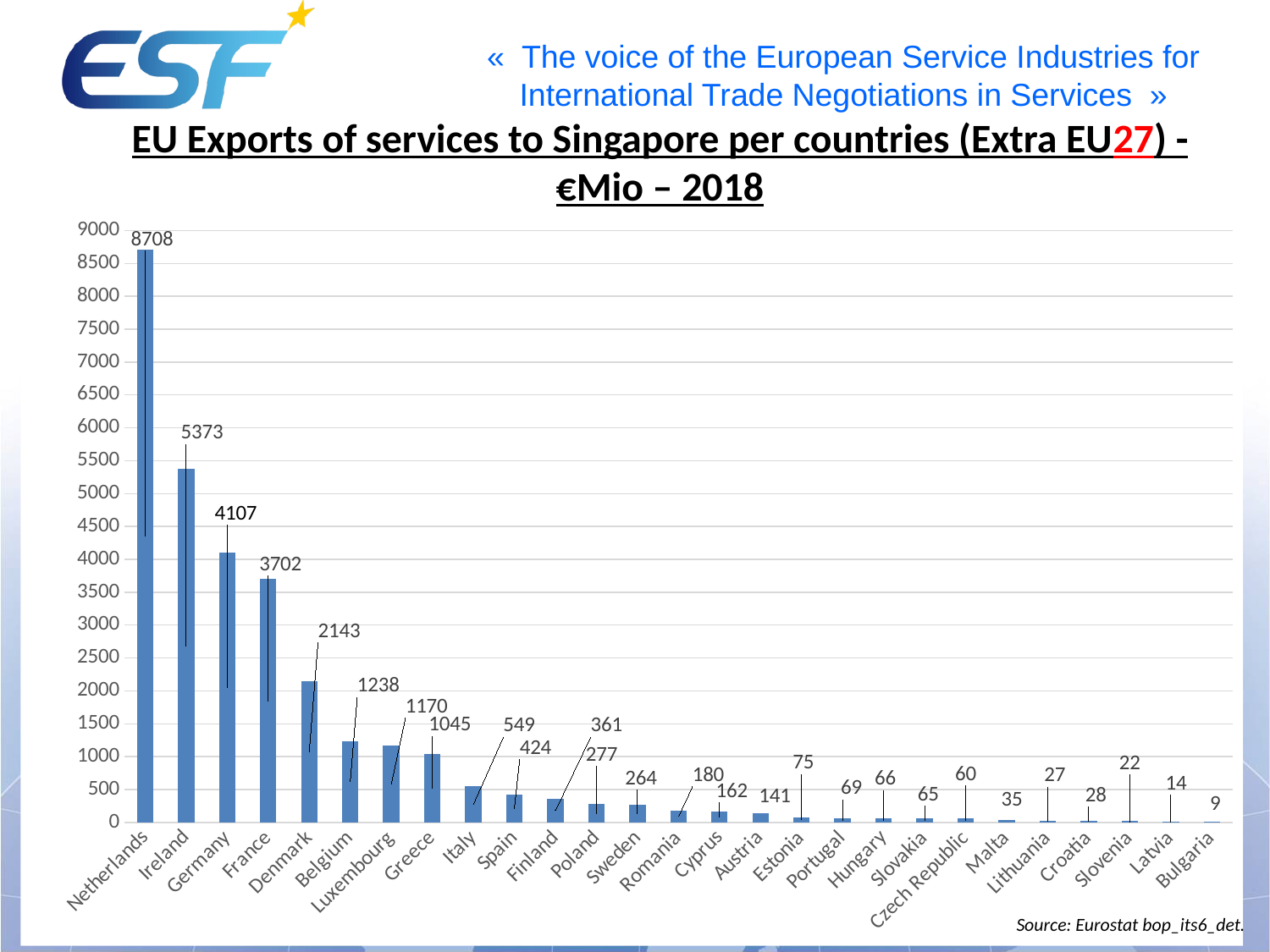
Which country has the highest value? Netherlands What is the value for Poland? 277 What is the value for the Netherlands? 8708 What is the difference between the values for Ireland and Germany? 1266 What kind of chart is shown on the slide? Bar chart Is the value for France greater or less than 3500? greater Which country has the lowest value? Bulgaria What is the title of the chart? EU Exports of services to Singapore per countries (Extra EU27) - €Mio – 2018 What is the value for Denmark? 2143 How many countries are shown on the x axis? 27 Which is larger, the value for Belgium or the value for Greece? Belgium Do the values rise or fall from left to right along the x axis? Fall